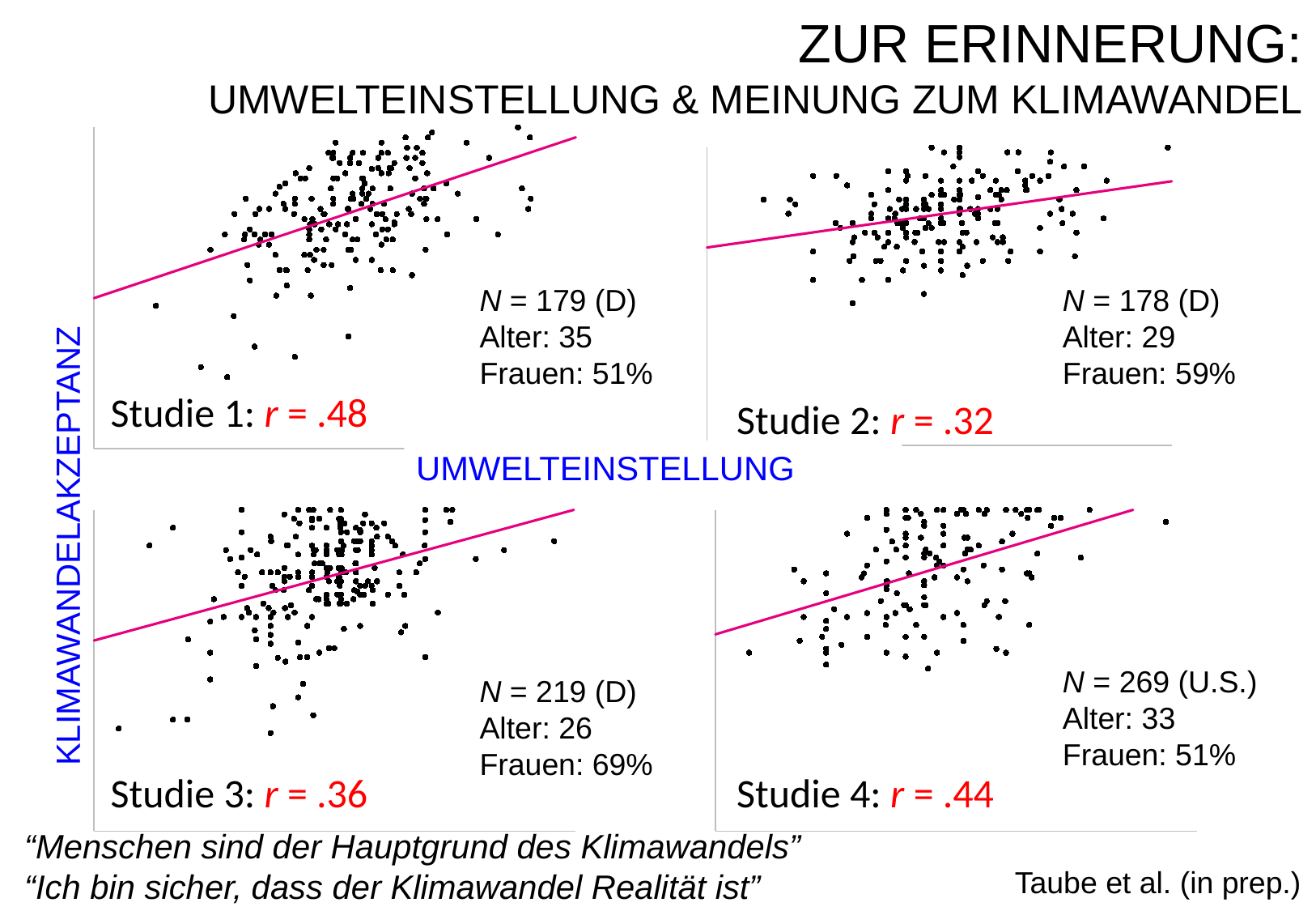
In the Studie 3 chart, what is the sample size N? 219 What is the difference between the r values of Studie 1 and Studie 2? .16 How many scatter plots are shown on the slide? 4 What is the label of the vertical axis shared by the charts? KLIMAWANDELAKZEPTANZ What kind of chart is used for Studie 1? scatter plot Which has the larger sample size N, Studie 3 or Studie 4? Studie 4 In the Studie 1 chart, what is the correlation coefficient r? .48 In the Studie 2 chart, what is the correlation coefficient r? .32 Which study's chart shows the lowest correlation r? Studie 2 In the Studie 4 chart, what percentage of participants were women (Frauen)? 51% In the Studie 4 chart, does the trend line rise or fall from left to right? rise Which study's chart shows the highest correlation r? Studie 1